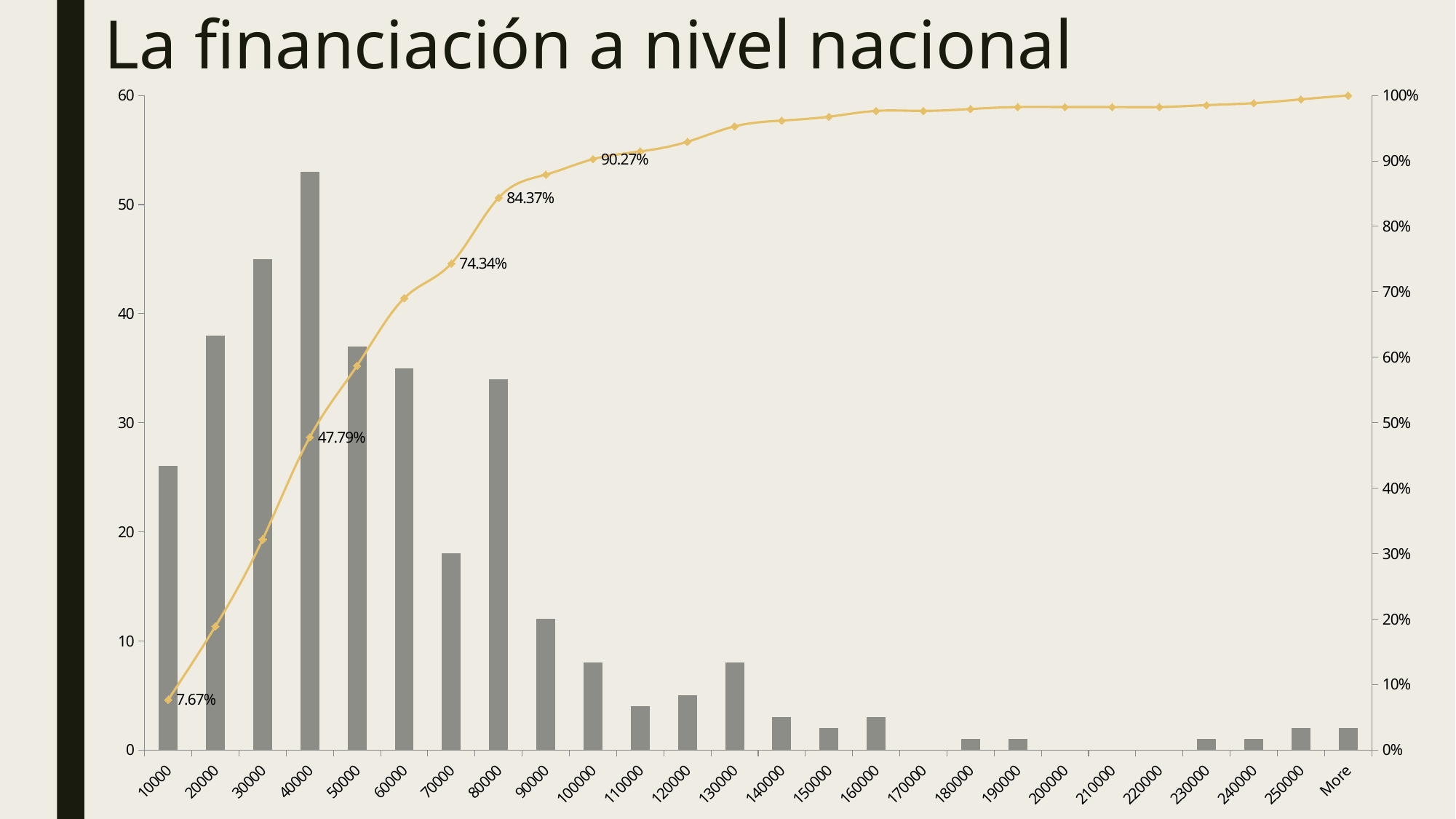
Which bar is taller, 30000 or 70000? 30000 What is the cumulative percentage value labelled on the line at the 40000 category? 47.79% Is the bar for 90000 greater or less than 20? less What is the cumulative percentage value labelled on the line at the 80000 category? 84.37% Is the bar for 40000 greater or less than 50? greater Which category has the tallest bar? 40000 Does the line series rise or fall as you move from left to right along the x axis? rises What is the cumulative percentage value labelled on the line at the 100000 category? 90.27% How many categories are shown on the x axis? 26 What is the cumulative percentage value labelled on the line at the 10000 category? 7.67% What is the title of the slide? La financiación a nivel nacional What is the cumulative percentage value labelled on the line at the 70000 category? 74.34%